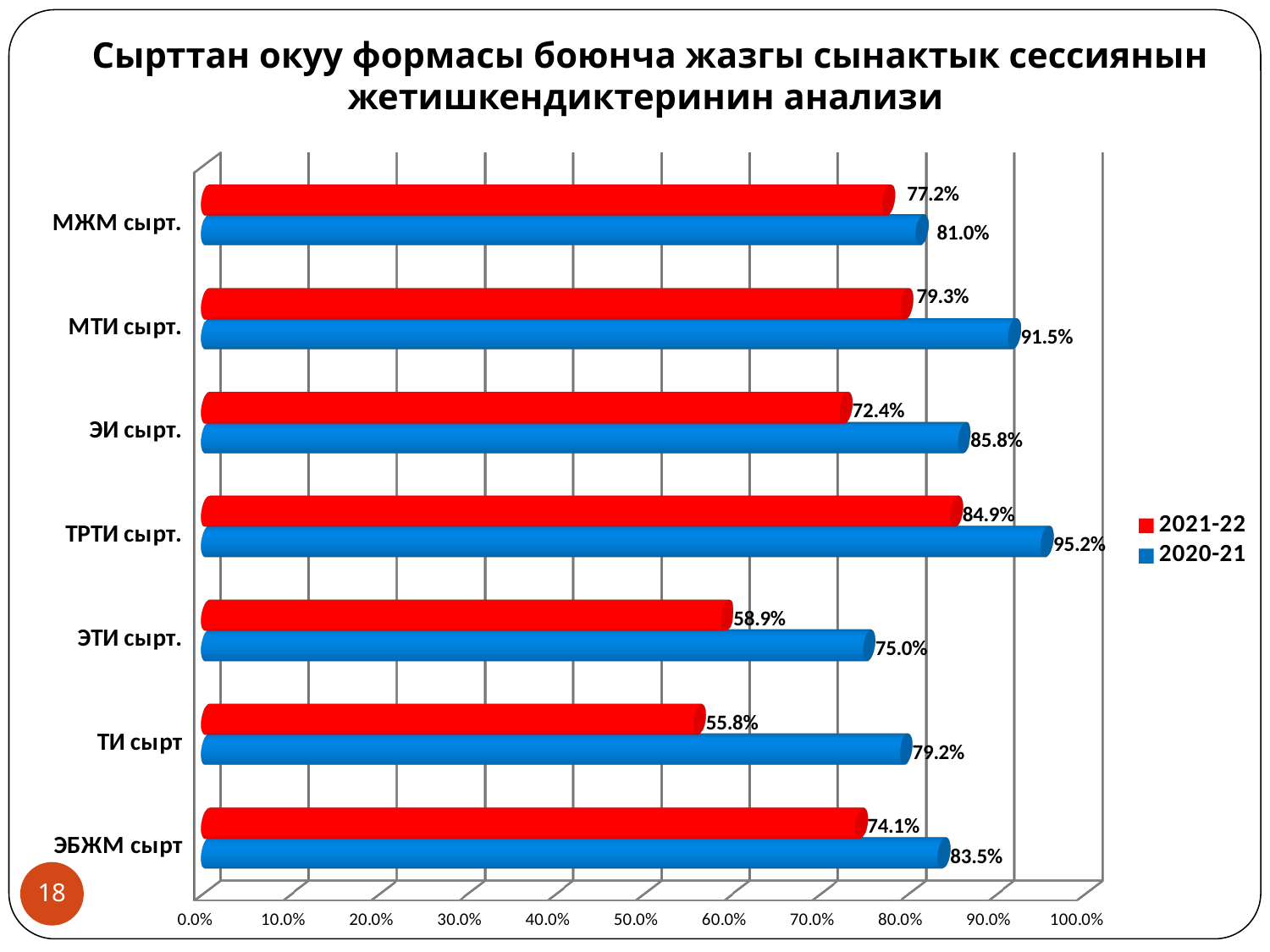
Which category has the lowest 2021-22 value? ТИ сырт What is the 2021-22 value for МТИ сырт.? 79.3% What is the 2020-21 value for ЭИ сырт.? 85.8% How many categories are shown on the chart? 7 How many series does the legend list? 2 Which colour represents the 2021-22 series? red Which is larger for МЖМ сырт.: the 2021-22 value or the 2020-21 value? 2020-21 What is the difference between the 2020-21 and 2021-22 values for ЭТИ сырт.? 16.1% What is the 2020-21 value for ТИ сырт? 79.2% Is the 2021-22 value for ЭБЖМ сырт greater or less than 70.0%? greater Which category has the highest 2020-21 value? ТРТИ сырт. What kind of chart is shown on the slide? bar chart